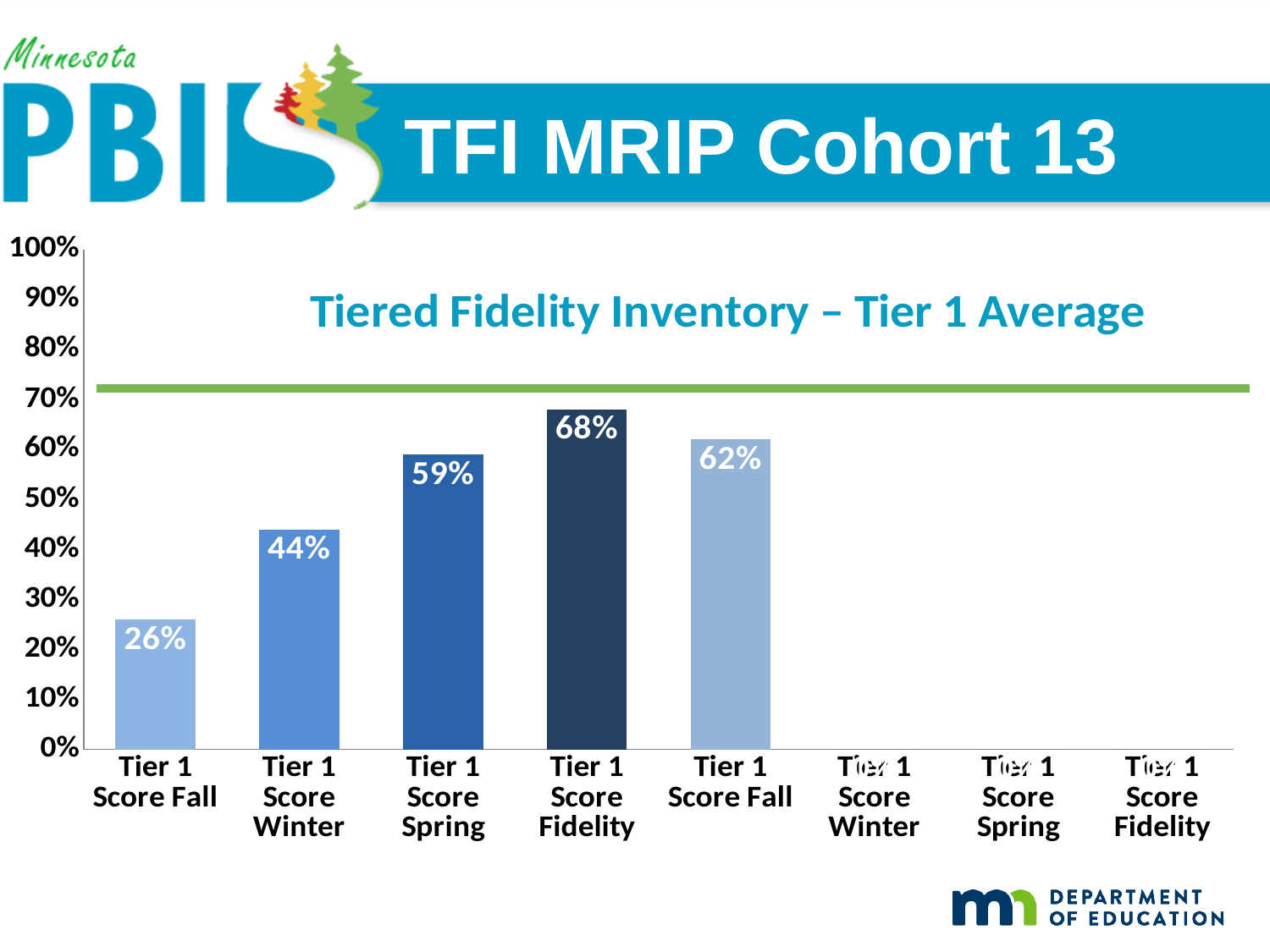
What is the value for Tier 1 Score Winter? 44% What is the title of the chart? Tiered Fidelity Inventory – Tier 1 Average What is the value for Tier 1 Score Spring? 59% Do the values rise or fall across the first four bars from left to right? rise What is the value of the first Tier 1 Score Fall bar (the leftmost bar)? 26% Which bar has the lowest value? Tier 1 Score Fall (the leftmost bar) What is the difference between the Tier 1 Score Fidelity value and the Tier 1 Score Winter value? 24% What type of chart is shown on the slide? bar chart What is the value for Tier 1 Score Fidelity? 68% What is the value of the second Tier 1 Score Fall bar (the fifth bar from the left)? 62% Which bar has the highest value? Tier 1 Score Fidelity Which is larger, the Tier 1 Score Spring value or the second Tier 1 Score Fall value? the second Tier 1 Score Fall value